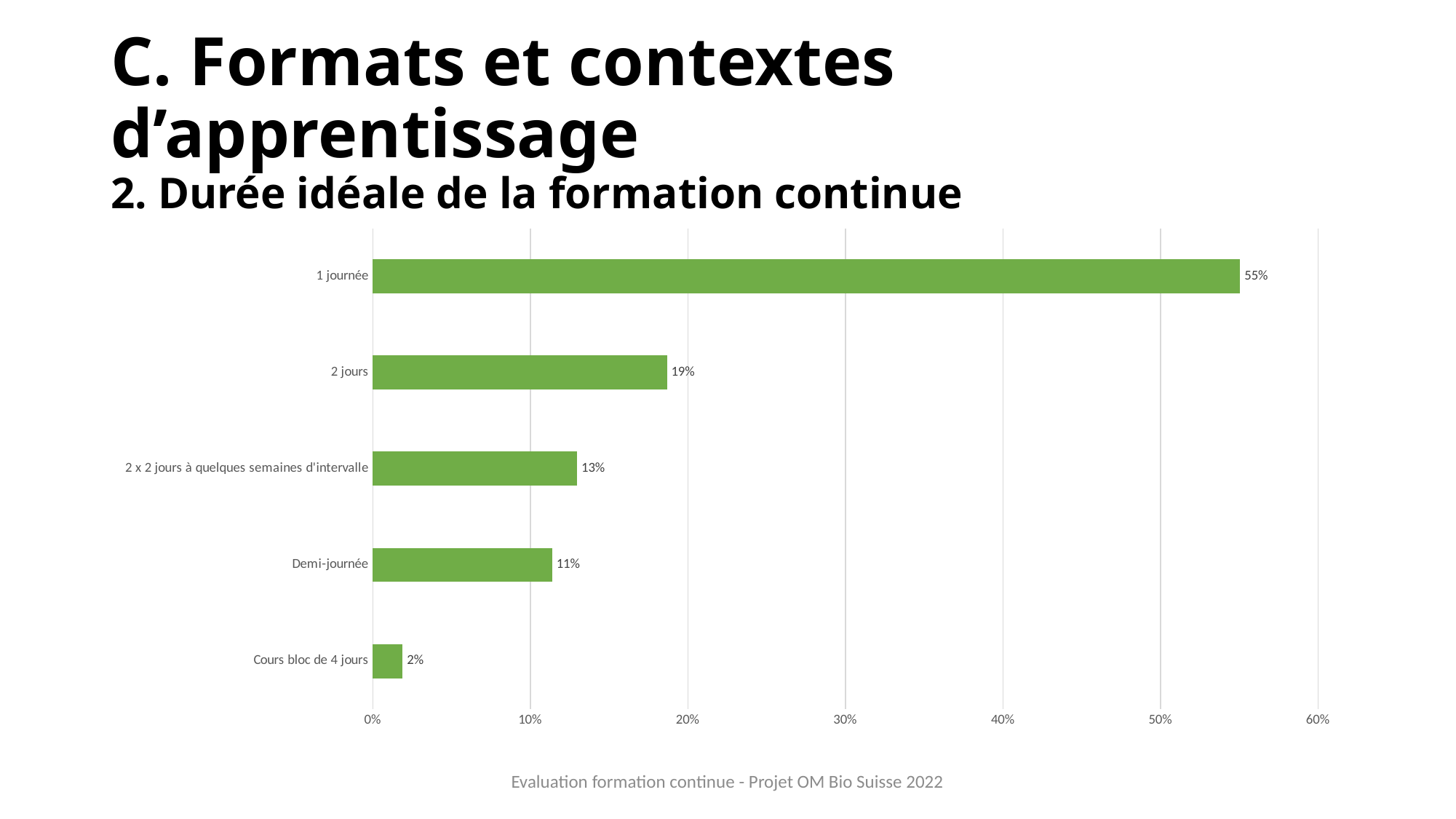
What is the value for "2 jours"? 19% Which category has the lowest value? Cours bloc de 4 jours What is the value for "2 x 2 jours à quelques semaines d'intervalle"? 13% What is the value for "Cours bloc de 4 jours"? 2% How many categories are shown in the chart? 5 Which category has the highest value? 1 journée What is the highest value shown on the x axis? 60% What is the difference between the values for "1 journée" and "2 jours"? 36% What is the value for "Demi-journée"? 11% What kind of chart is shown on the slide? Bar chart What is the value for "1 journée"? 55% Which is larger, the value for "2 jours" or the value for "Demi-journée"? 2 jours